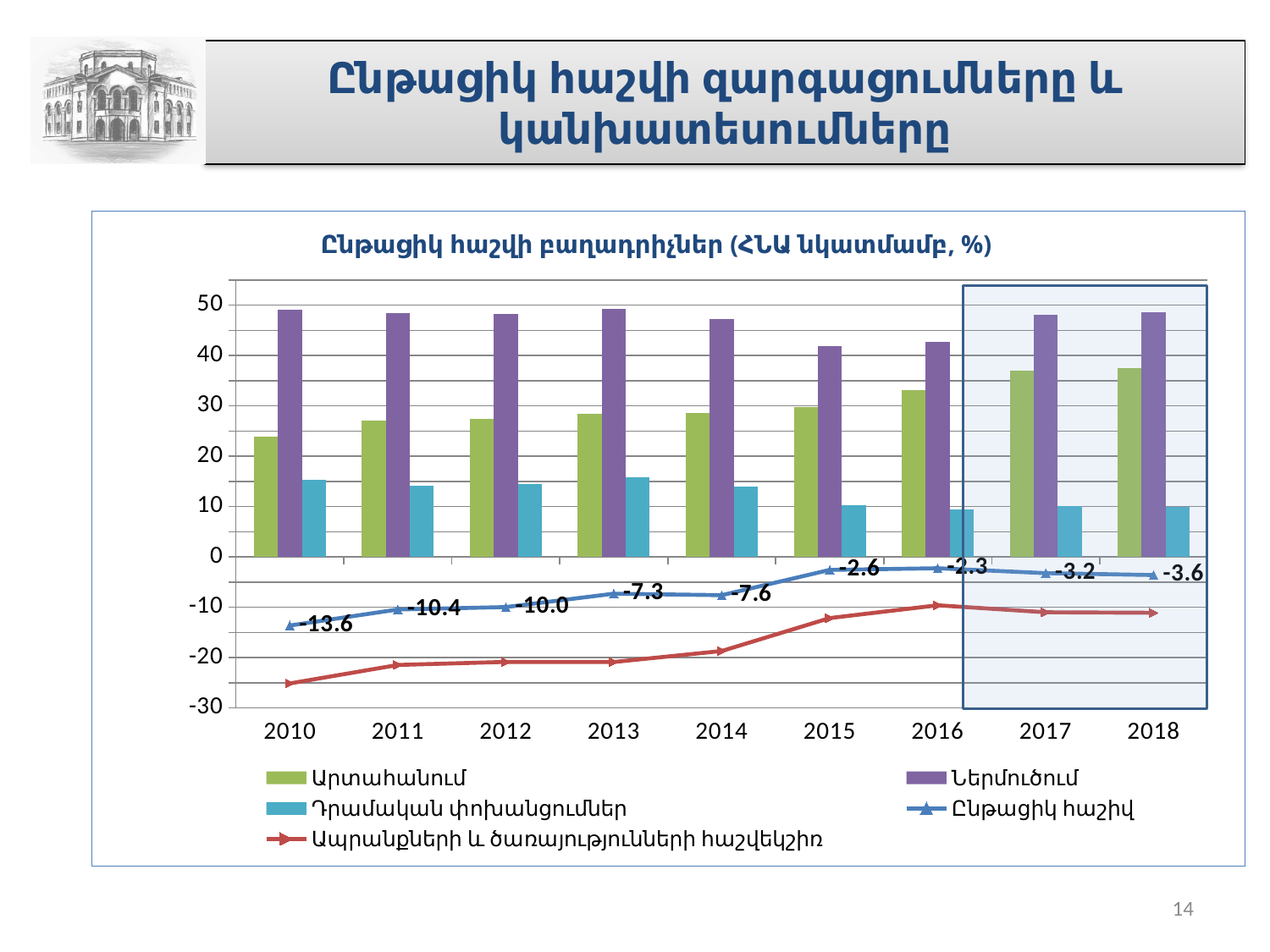
What is the value of the Ընթացիկ հաշիվ line in 2010? -13.6 What is the value of the Ընթացիկ հաշիվ line in 2018? -3.6 How many years are shown on the x axis of the chart? 9 What is the difference between the Ընթացիկ հաշիվ values for 2018 and 2010? 10.0 In which year is the Ընթացիկ հաշիվ line at its highest value? 2016 In which year is the Ընթացիկ հաշիվ line at its lowest value? 2010 Is the value of the Արտահանում bar for 2010 greater or less than 30? less What is the value of the Ընթացիկ հաշիվ line in 2016? -2.3 How many series does the legend list? 5 What kind of chart is shown on the slide? Combined bar and line chart Which is larger, the Ընթացիկ հաշիվ value for 2013 or for 2014? 2013 Is the value of the Ներմուծում bar for 2010 greater or less than 40? greater